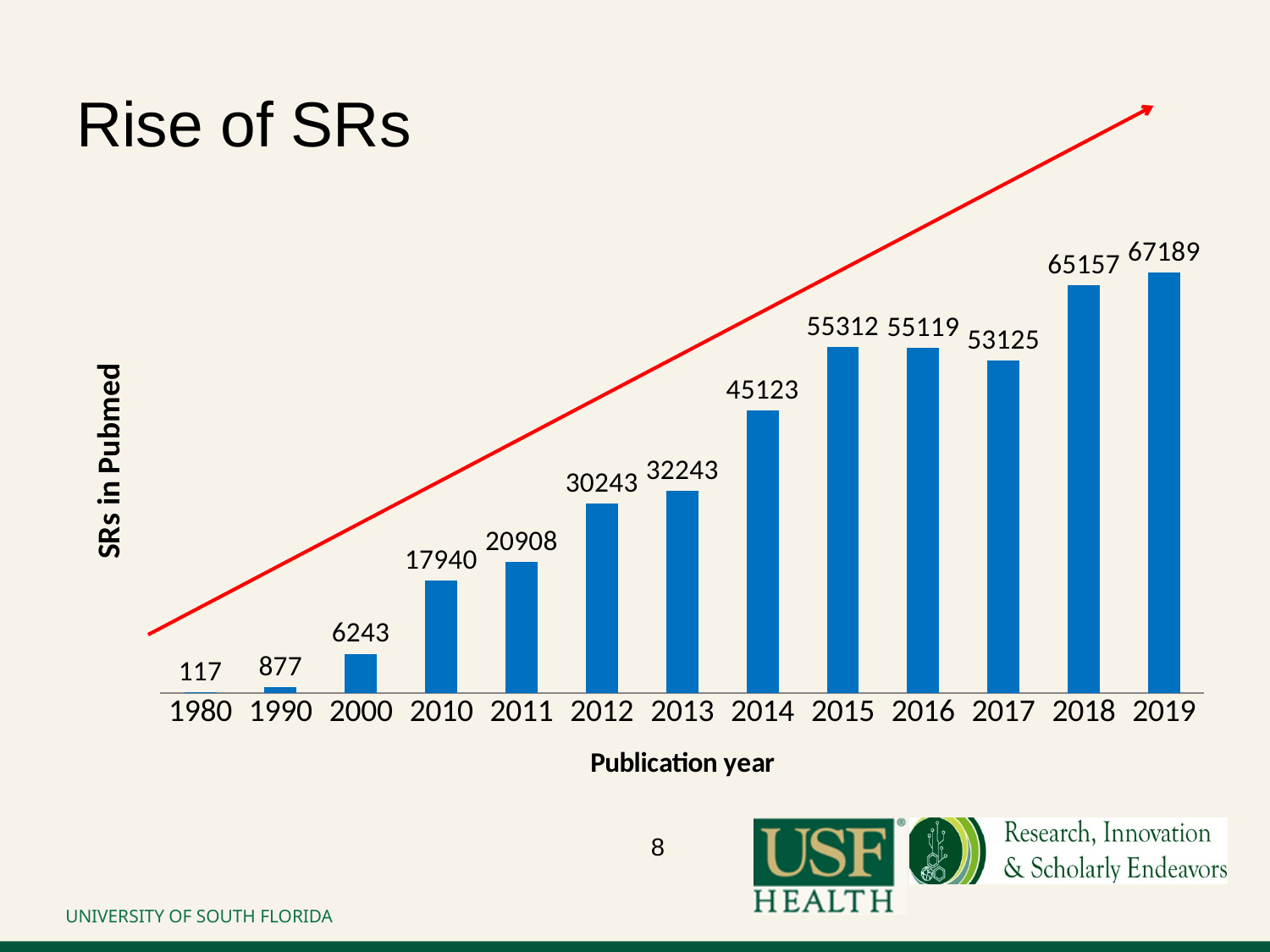
What is the number of SRs in Pubmed for publication year 2014? 45123 Which publication year has the highest number of SRs in Pubmed? 2019 What is the difference between the number of SRs in 2019 and in 2018? 2032 What is the label of the y axis? SRs in Pubmed Which publication year has the lowest number of SRs in Pubmed? 1980 What is the difference between the number of SRs in 2015 and in 2017? 2187 What kind of chart is shown on the slide? Bar chart How many publication years are shown on the x axis? 13 What is the number of SRs in Pubmed for publication year 1980? 117 What is the number of SRs in Pubmed for publication year 2010? 17940 Do the values generally rise or fall from 1980 to 2019? Rise Which year has more SRs in Pubmed, 2016 or 2017? 2016